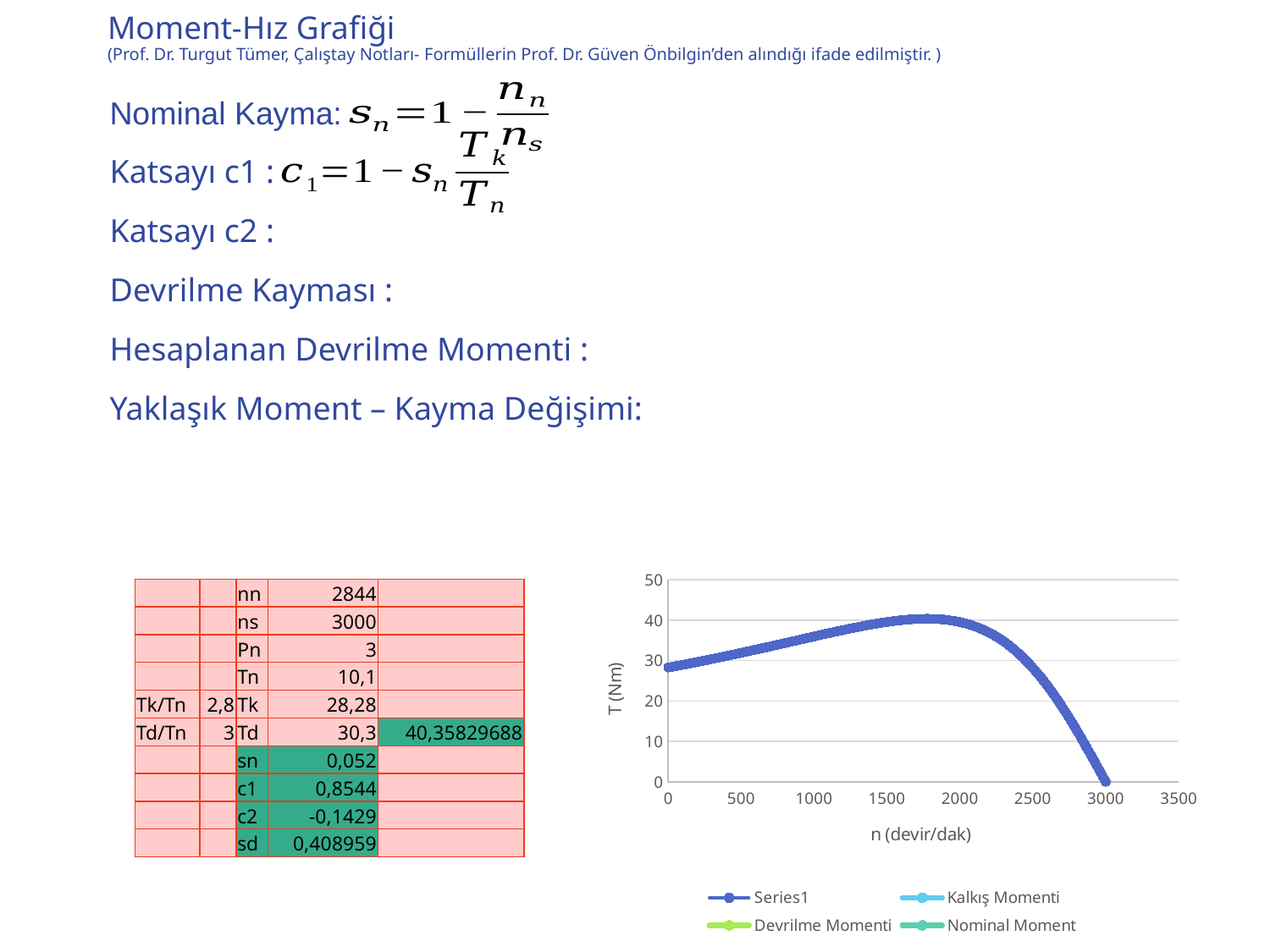
Is the value of Series1 at n = 1000 greater or less than 40? less Is the value of Series1 at n = 0 greater or less than 20? greater What kind of chart is shown on the slide? line chart Is the value of Series1 at n = 2000 greater or less than 30? greater At which n value does the Series1 curve reach T = 0? 3000 What is the title of the chart's vertical axis? T (Nm) Does the Series1 curve rise or fall between n = 2000 and n = 3000? fall What is the title of the chart's horizontal axis? n (devir/dak) Does the Series1 curve rise or fall between n = 0 and n = 1500? rise How many series does the chart legend list? 4